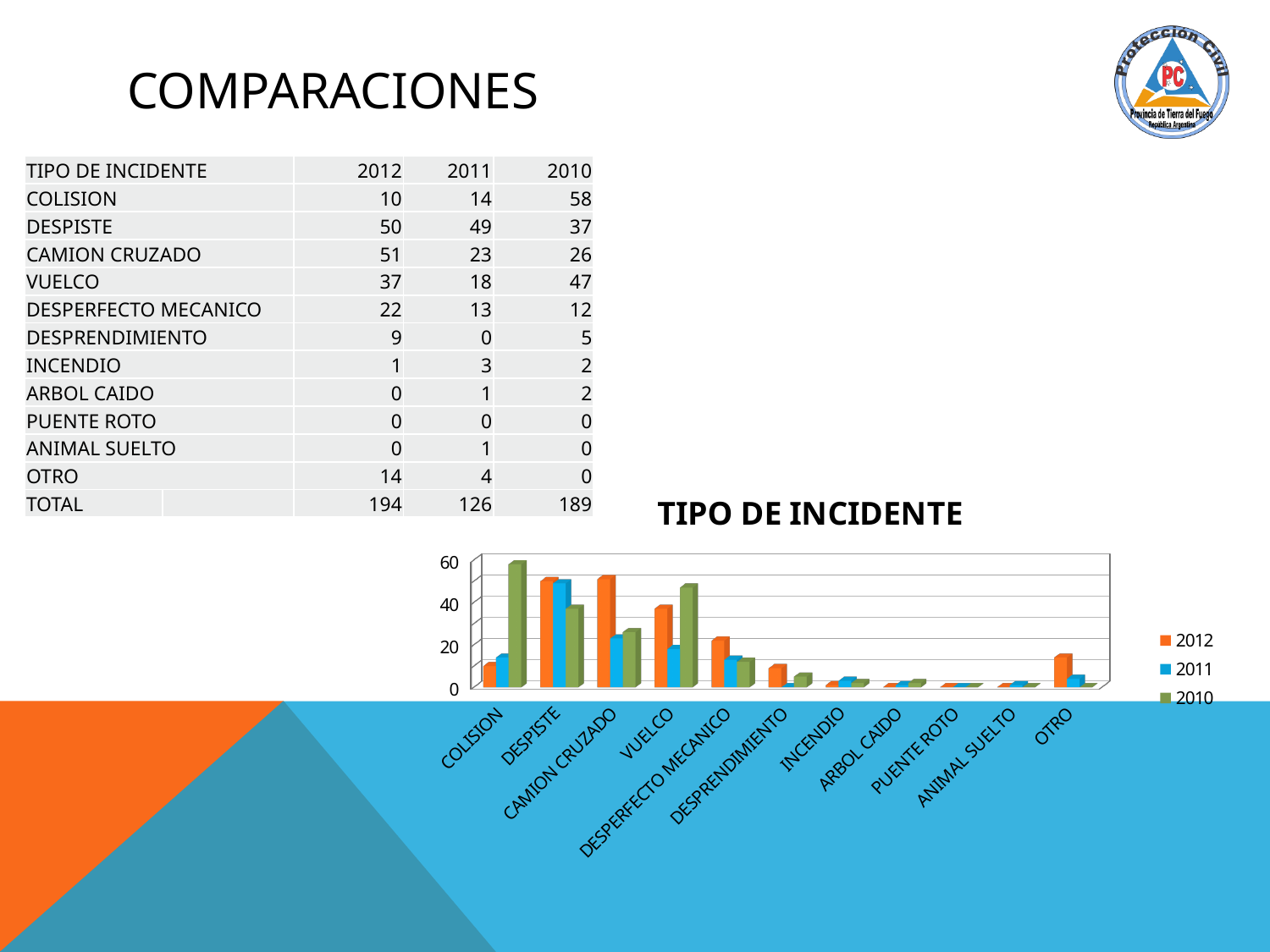
Is the 2011 value for CAMION CRUZADO in the chart greater or less than 40? less According to the table, what is the TOTAL for 2011? 126 What kind of chart is shown under the title TIPO DE INCIDENTE? bar chart Is the 2010 value for COLISION in the chart greater or less than 40? greater According to the table, what is the difference between the 2010 and 2012 values for COLISION? 48 According to the table, what is the 2012 value for CAMION CRUZADO? 51 How many series does the legend of the TIPO DE INCIDENTE chart list? 3 In the chart, which is larger for VUELCO: the 2012 value or the 2011 value? 2012 How many incident categories are shown on the x axis of the TIPO DE INCIDENTE chart? 11 Which category has the highest value for the 2010 series in the TIPO DE INCIDENTE chart? COLISION Which colour represents the 2012 series in the TIPO DE INCIDENTE chart? orange According to the table, what is the 2011 value for DESPISTE? 49